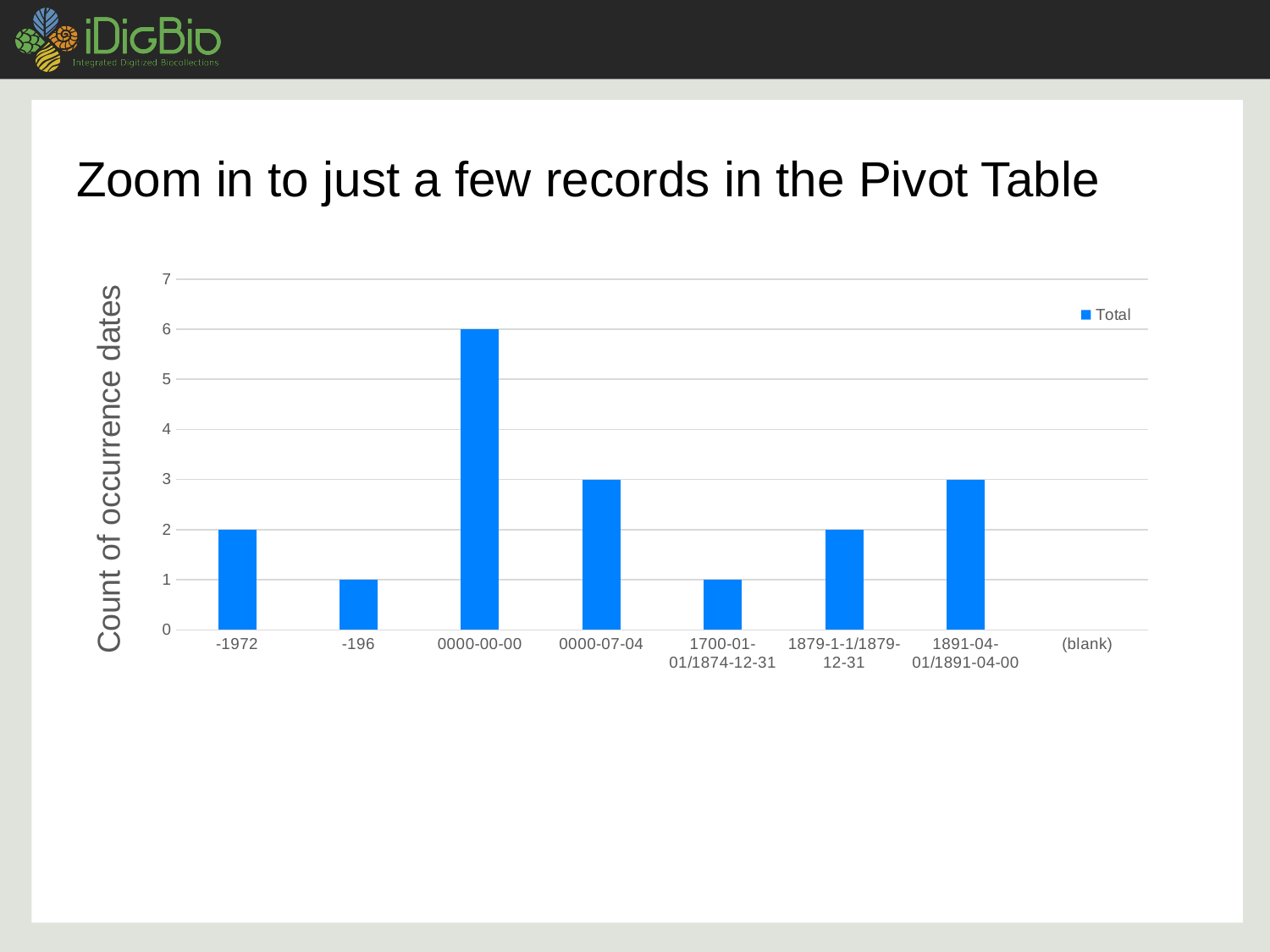
What kind of chart is shown on the slide? Bar chart What is the difference between the count for 0000-00-00 and the count for 0000-07-04? 3 How many categories are shown on the x axis of the chart? 8 What is the label of the y axis of the chart? Count of occurrence dates How many series does the chart legend list? 1 Is the count of occurrence dates for 0000-00-00 greater or less than 5? greater What is the count of occurrence dates for the category -196? 1 Which category has the highest count of occurrence dates? 0000-00-00 What is the count of occurrence dates for the category 0000-07-04? 3 What is the count of occurrence dates for the category 0000-00-00? 6 Which has a larger count of occurrence dates, -1972 or -196? -1972 What is the count of occurrence dates for the category -1972? 2